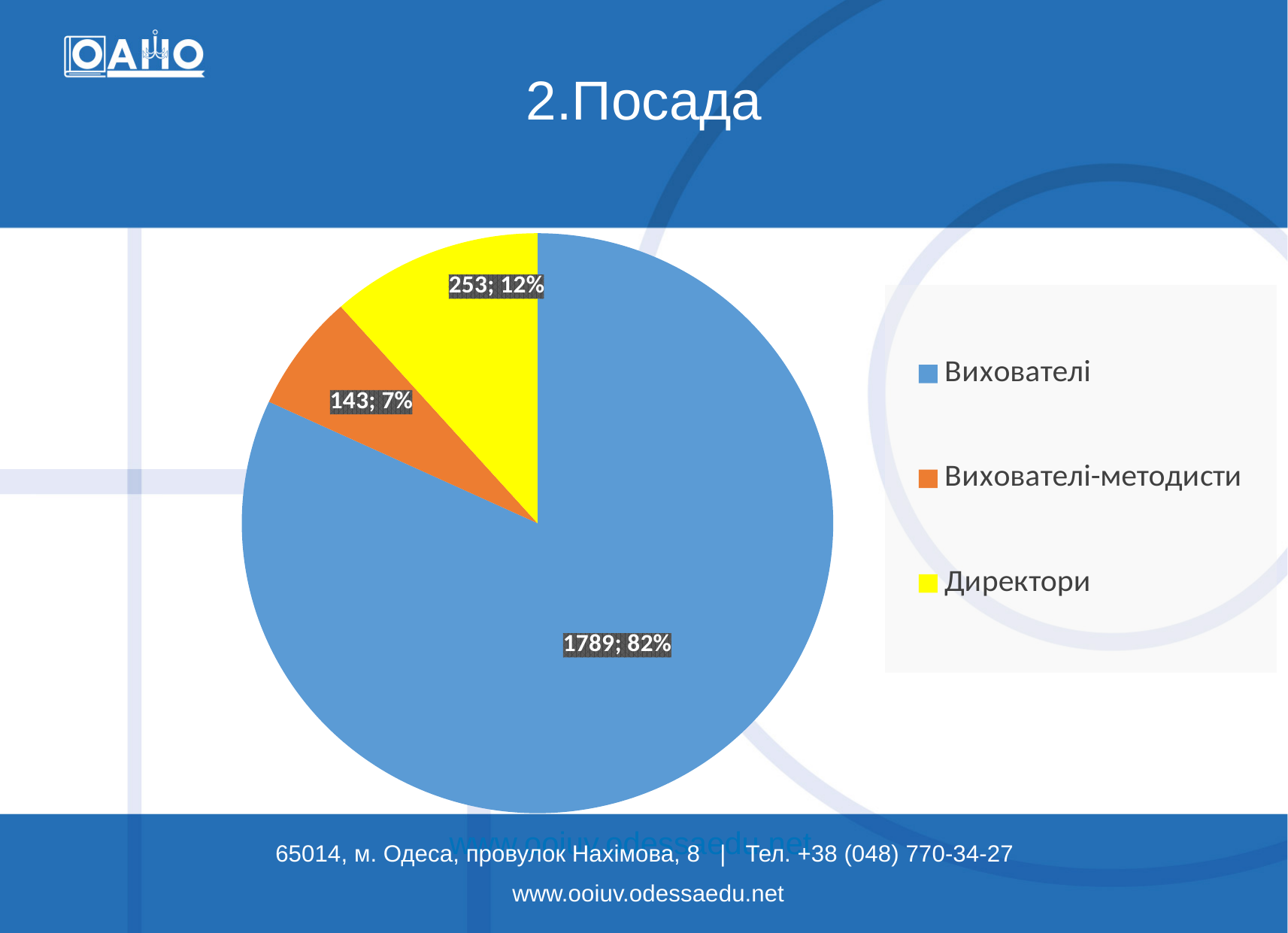
How many entries does the legend list? 3 What share of the pie does Директори represent? 12% What is the value for Вихователі? 1789 What is the difference between the values for Директори and Вихователі-методисти? 110 Which colour represents Директори in the pie chart? yellow Which category has the smallest slice? Вихователі-методисти What kind of chart is shown on the slide? pie chart How many slices does the pie chart have? 3 What is the value for Директори? 253 Which category has the largest slice? Вихователі What share of the pie does Вихователі represent? 82% What is the value for Вихователі-методисти? 143